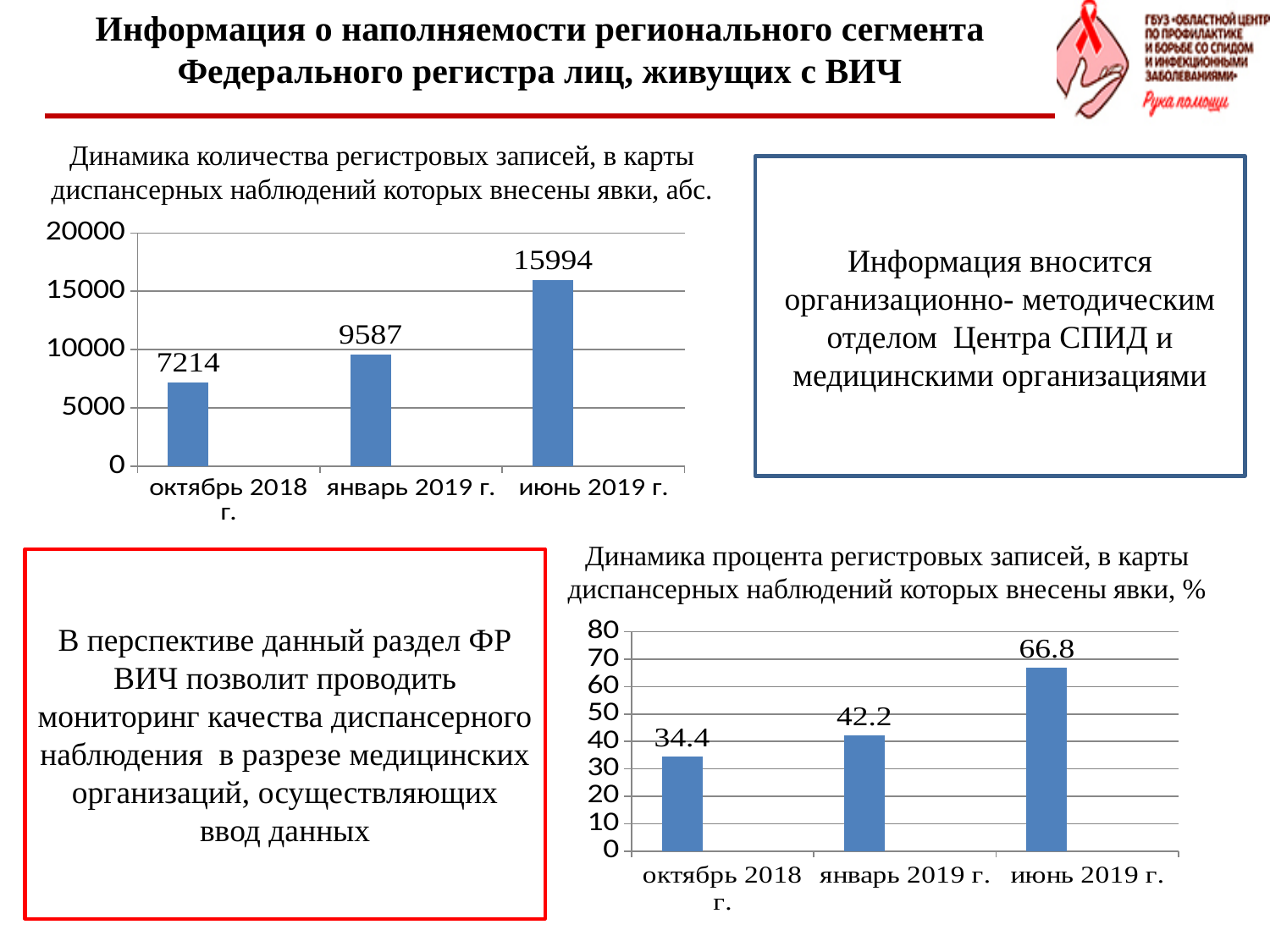
In the top-left chart (Динамика количества регистровых записей), what is the difference between the values for июнь 2019 г. and октябрь 2018 г.? 8780 In the bottom-right chart (Динамика процента регистровых записей), which is larger, the value for январь 2019 г. or the value for июнь 2019 г.? июнь 2019 г. In the bottom-right chart (Динамика процента регистровых записей), is the value for январь 2019 г. greater or less than 50? less In the top-left chart (Динамика количества регистровых записей), how many categories are shown on the x axis? 3 In the top-left chart (Динамика количества регистровых записей), which category has the highest value? июнь 2019 г. In the top-left chart (Динамика количества регистровых записей), do the values rise or fall from октябрь 2018 г. to июнь 2019 г.? rise In the top-left chart (Динамика количества регистровых записей), what is the value for январь 2019 г.? 9587 What type of chart is the bottom-right chart (Динамика процента регистровых записей)? bar chart In the bottom-right chart (Динамика процента регистровых записей), what is the difference between the values for январь 2019 г. and октябрь 2018 г.? 7.8 In the top-left chart (Динамика количества регистровых записей), which category has the lowest value? октябрь 2018 г. In the bottom-right chart (Динамика процента регистровых записей), what is the value for июнь 2019 г.? 66.8 In the bottom-right chart (Динамика процента регистровых записей), what is the value for октябрь 2018 г.? 34.4